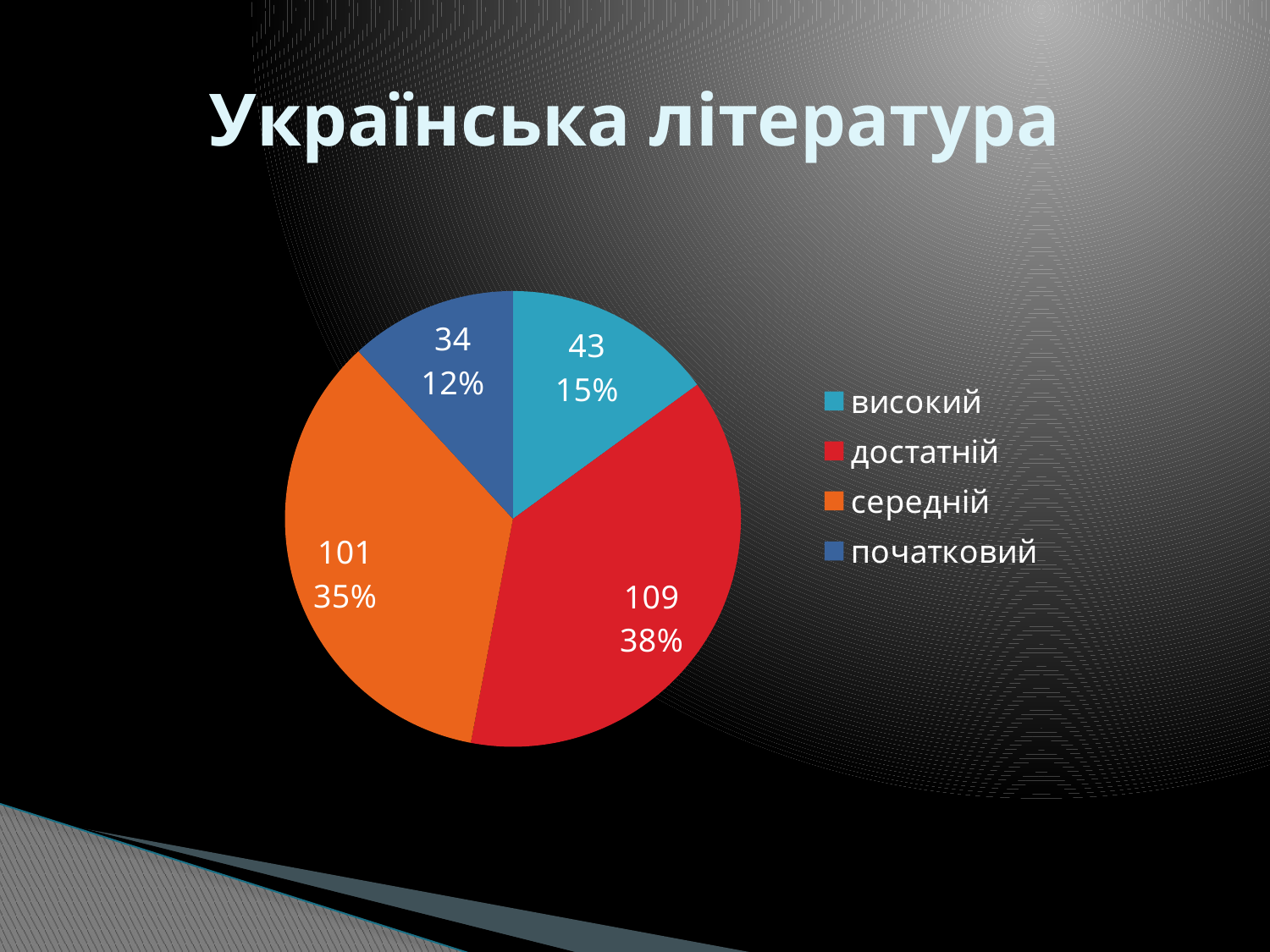
What is the value for початковий? 34 What is the value for середній? 101 What is the difference between the values for достатній and середній? 8 What share of the pie does початковий take? 12% What kind of chart is shown on the slide? pie chart What is the value for високий? 43 Which category has the smallest slice? початковий What is the value for достатній? 109 How many categories does the pie chart have? 4 Which is larger, the value for високий or the value for початковий? високий What share of the pie does середній take? 35% Which category has the largest slice? достатній